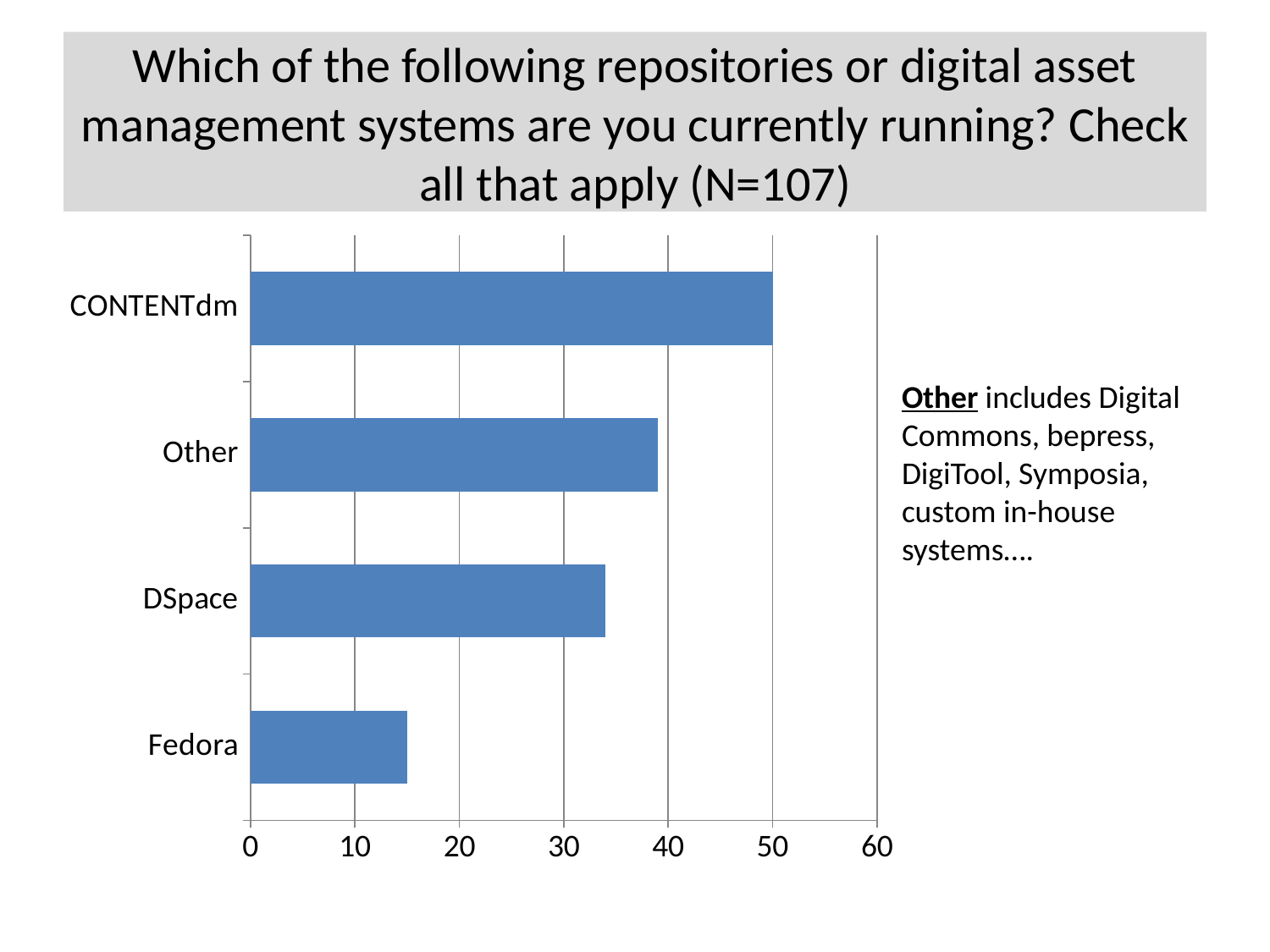
What is the value for CONTENTdm? 50 What kind of chart is shown on the slide? bar chart What is the N (number of respondents) given in the chart title? 107 How many repository or digital asset management systems are listed as categories in the chart? 4 Is the value for Fedora greater or less than 20? less Which has a larger value, Other or DSpace? Other According to the note on the slide, which category includes Digital Commons, bepress, DigiTool and Symposia? Other Which system has the highest value in the chart? CONTENTdm Which system has the lowest value in the chart? Fedora Is the value for Other greater or less than 30? greater Is the value for DSpace greater or less than 30? greater